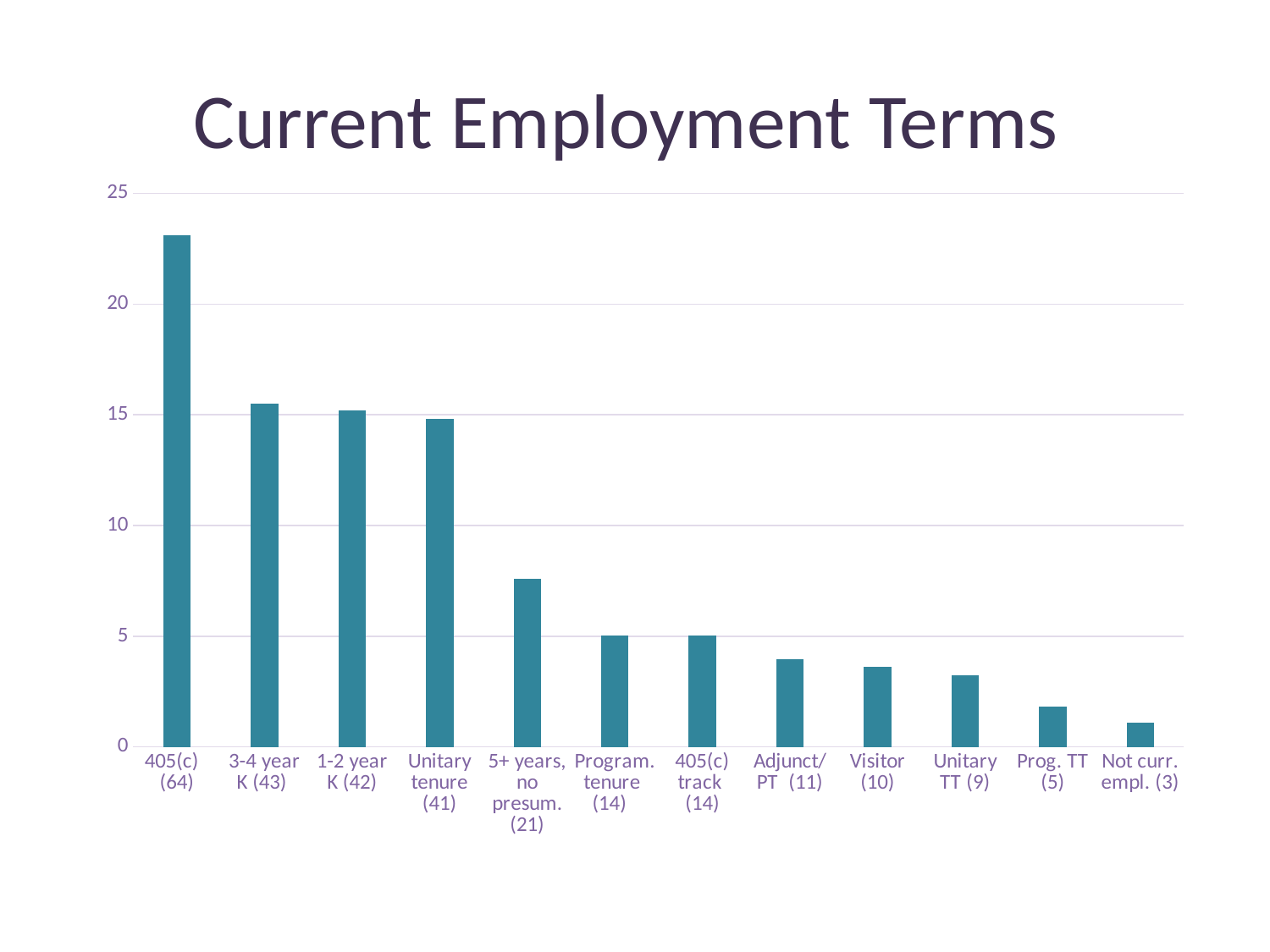
Is the value for 5+ years, no presum. (21) greater or less than 5? greater Which is larger, the value for 405(c) (64) or the value for 3-4 year K (43)? 405(c) (64) What is the title of the chart? Current Employment Terms How many categories are shown on the x axis of the chart? 12 Is the value for Adjunct/PT (11) greater or less than 5? less Which is larger, the value for 5+ years, no presum. (21) or the value for Visitor (10)? 5+ years, no presum. (21) What kind of chart is shown on the slide? bar chart Which category has the lowest bar? Not curr. empl. (3) Which category has the highest bar? 405(c) (64) Is the value for Prog. TT (5) greater or less than 5? less Do the bar values generally rise or fall from left to right along the x axis? fall